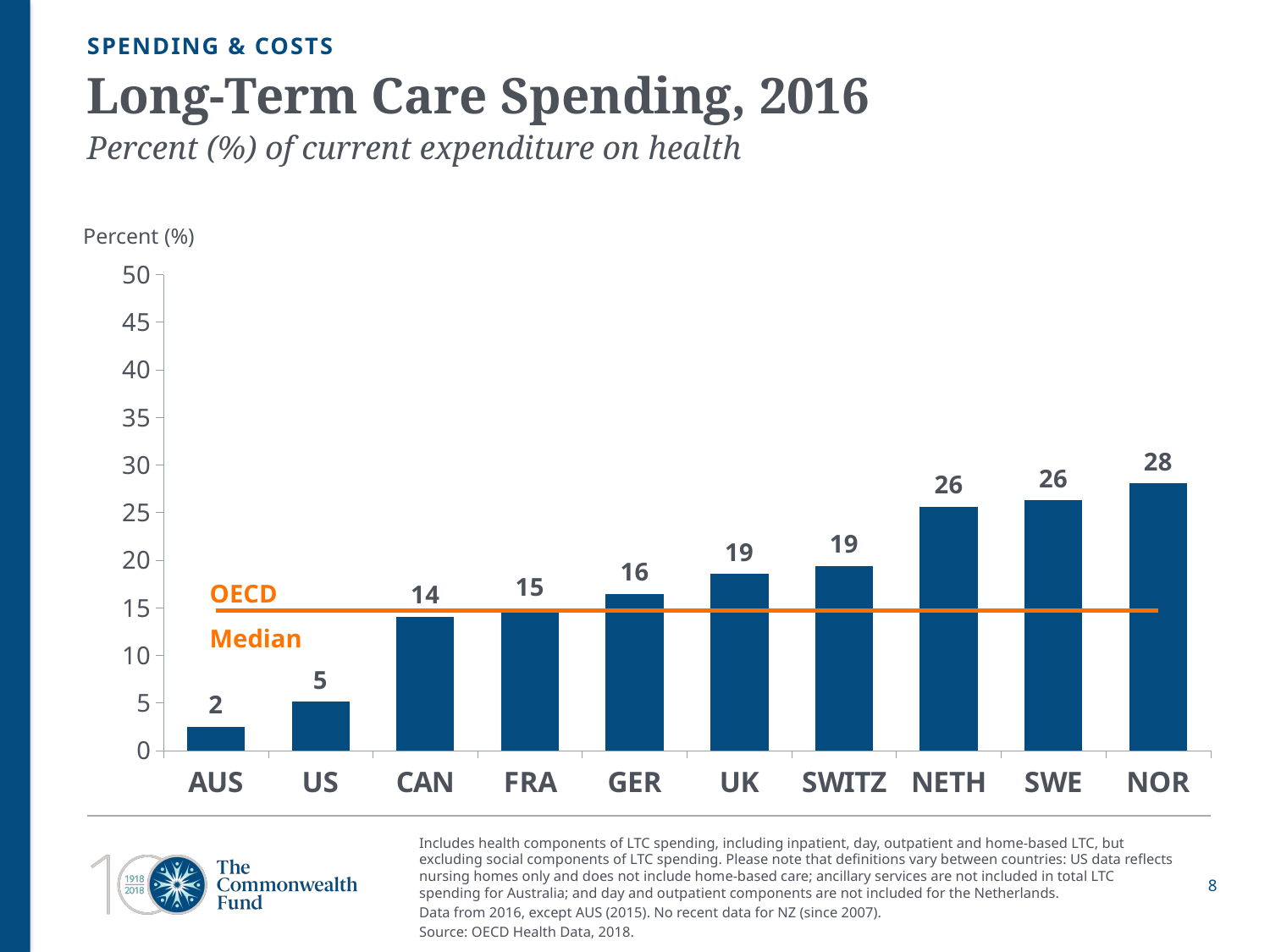
What is the long-term care spending value for the US? 5 What is the difference between the values for UK and CAN? 5 How many countries are shown on the chart? 10 Which country has the highest long-term care spending as a percent of current health expenditure? NOR What is the difference between the values for NOR and AUS? 26 What does the orange horizontal line on the chart represent? OECD Median Is the value for NOR greater or less than 25? greater Which country has the lowest value on the chart? AUS Which is larger, the value for FRA or the value for SWE? SWE What is the long-term care spending value for Germany (GER)? 16 What type of chart is shown on the slide? Bar chart What is the value shown for NETH? 26